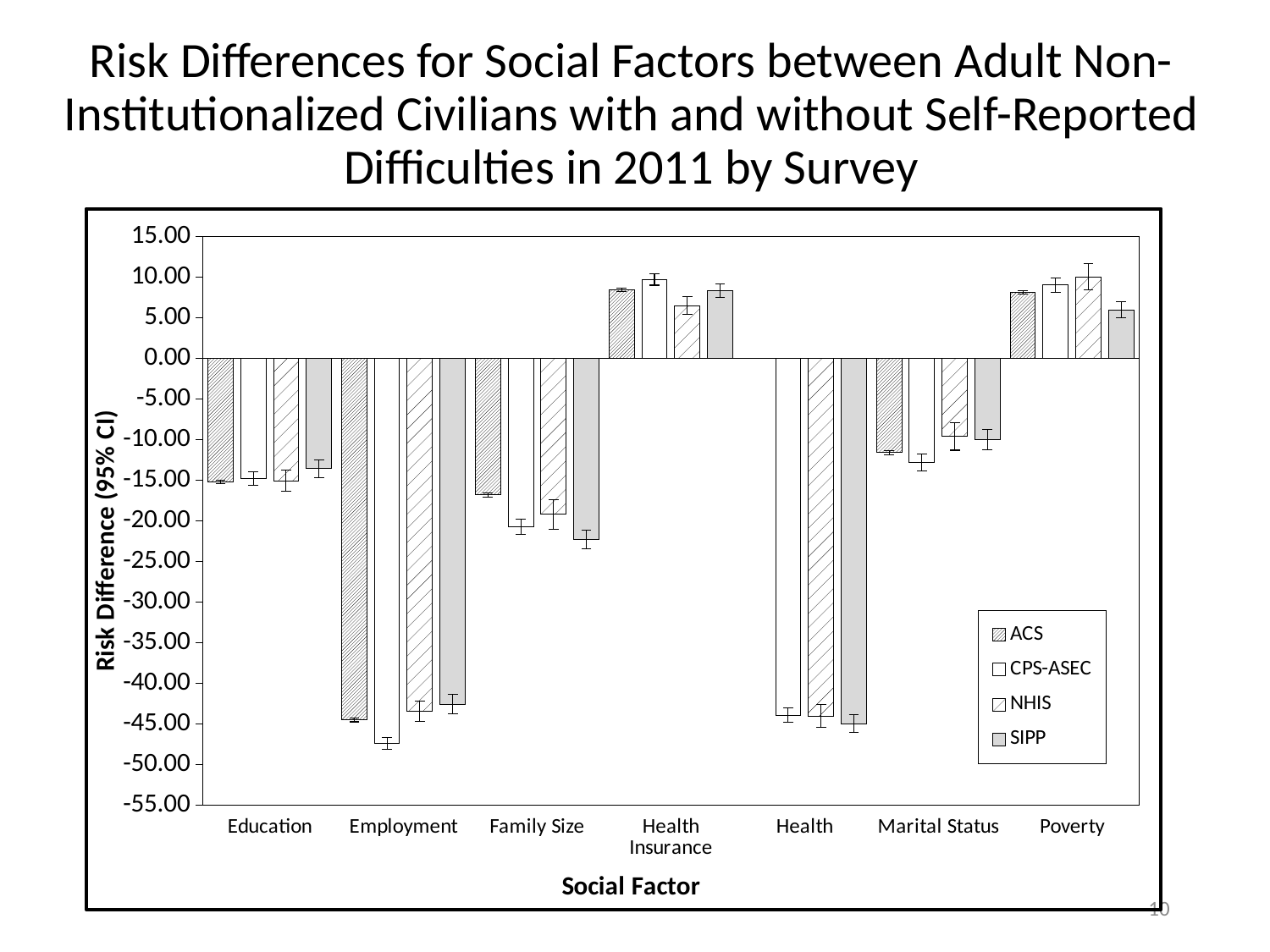
Is the ACS value for Education greater or less than -20.00? greater How many bars are plotted for the Health category? 3 Which social factor has the lowest CPS-ASEC value? Employment For the ACS series, which is larger: the value for Education or the value for Employment? Education Is the CPS-ASEC value for Employment greater or less than -45.00? less What is the title of the y axis? Risk Difference (95% CI) How many social factors are shown on the x axis? 7 What kind of chart is shown on the slide? bar chart Which social factor has the highest NHIS value? Poverty How many series does the legend list? 4 Is the SIPP value for Family Size greater or less than -20.00? less